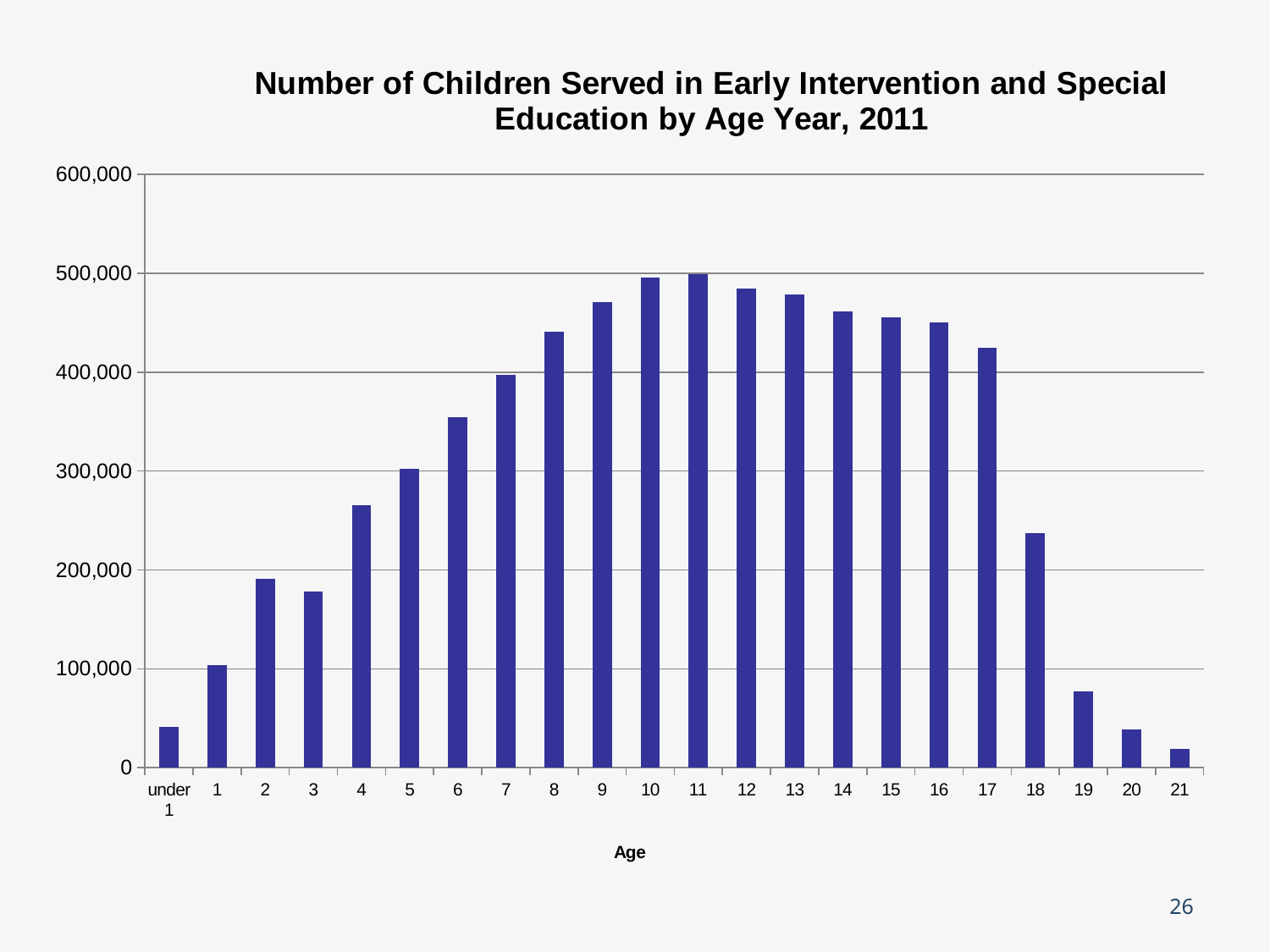
Is the value for age 6 greater or less than 300,000? greater Which is larger, the value for age 4 or the value for age 18? age 4 How many age categories are shown on the x axis? 22 What kind of chart is shown on the slide? bar chart Do the values rise or fall from age 11 to age 21? fall Which age category has the lowest number of children served? 21 Is the value for age 18 greater or less than 200,000? greater Is the value for age 17 greater or less than 400,000? greater What is the label of the x axis? Age Which is larger, the value for age 2 or the value for age 3? age 2